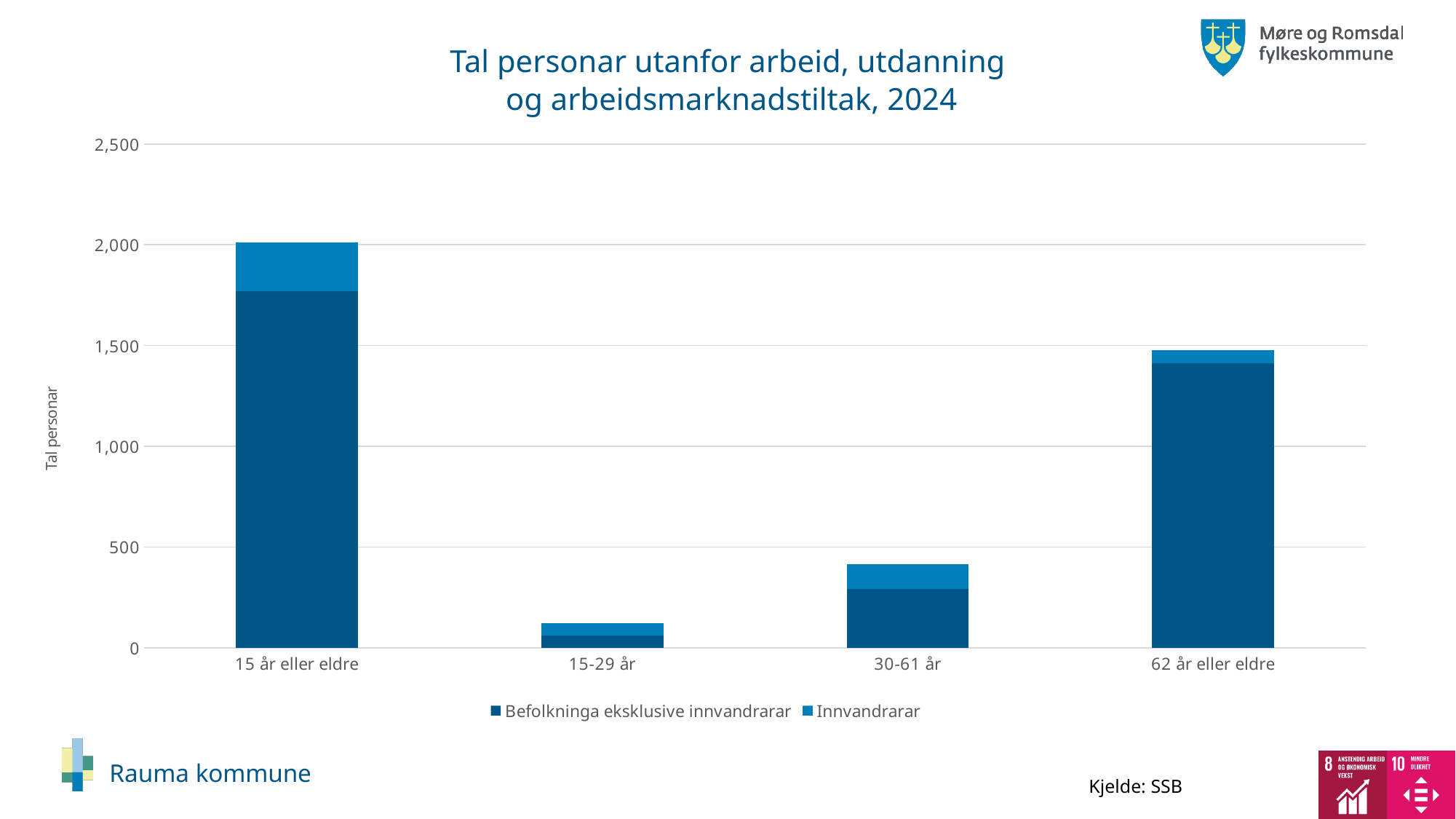
Is the total value for 62 år eller eldre greater or less than 1,500? less Which stacked bar is taller, 30-61 år or 62 år eller eldre? 62 år eller eldre Is the total value for 15-29 år greater or less than 500? less Which age category has the tallest stacked bar? 15 år eller eldre How many age categories are shown on the x axis? 4 How many series does the legend list? 2 Is the total value for 30-61 år greater or less than 500? less What source is cited for the chart data? SSB What kind of chart is shown on the slide? Stacked bar chart Which age category has the shortest stacked bar? 15-29 år What is the label of the y axis? Tal personar